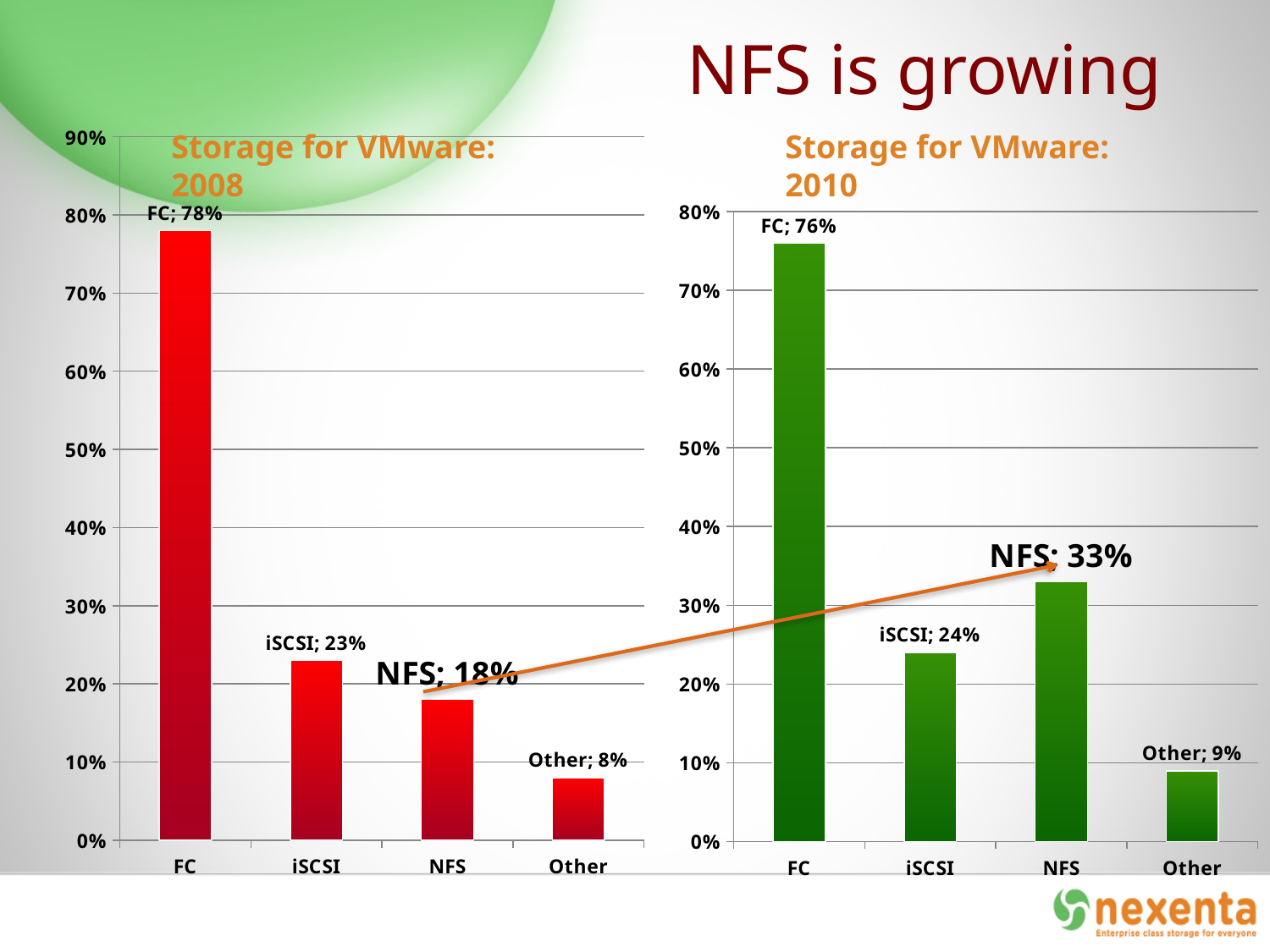
In the 'Storage for VMware: 2010' chart, which is larger, the value for iSCSI or the value for NFS? NFS In the 'Storage for VMware: 2010' chart, what is the value for NFS? 33% In the 'Storage for VMware: 2008' chart, what is the value for Other? 8% In the 'Storage for VMware: 2010' chart, what is the difference between the values for FC and NFS? 43% What colour are the bars in the 'Storage for VMware: 2008' chart? Red How many categories are shown in the 'Storage for VMware: 2008' chart? 4 In the 'Storage for VMware: 2010' chart, which category has the highest value? FC What kind of chart is the 'Storage for VMware: 2010' chart? Bar chart In the 'Storage for VMware: 2008' chart, which category has the lowest value? Other In the 'Storage for VMware: 2008' chart, what is the difference between the values for iSCSI and NFS? 5% In the 'Storage for VMware: 2008' chart, what is the value for FC? 78% In the 'Storage for VMware: 2010' chart, what is the value for iSCSI? 24%